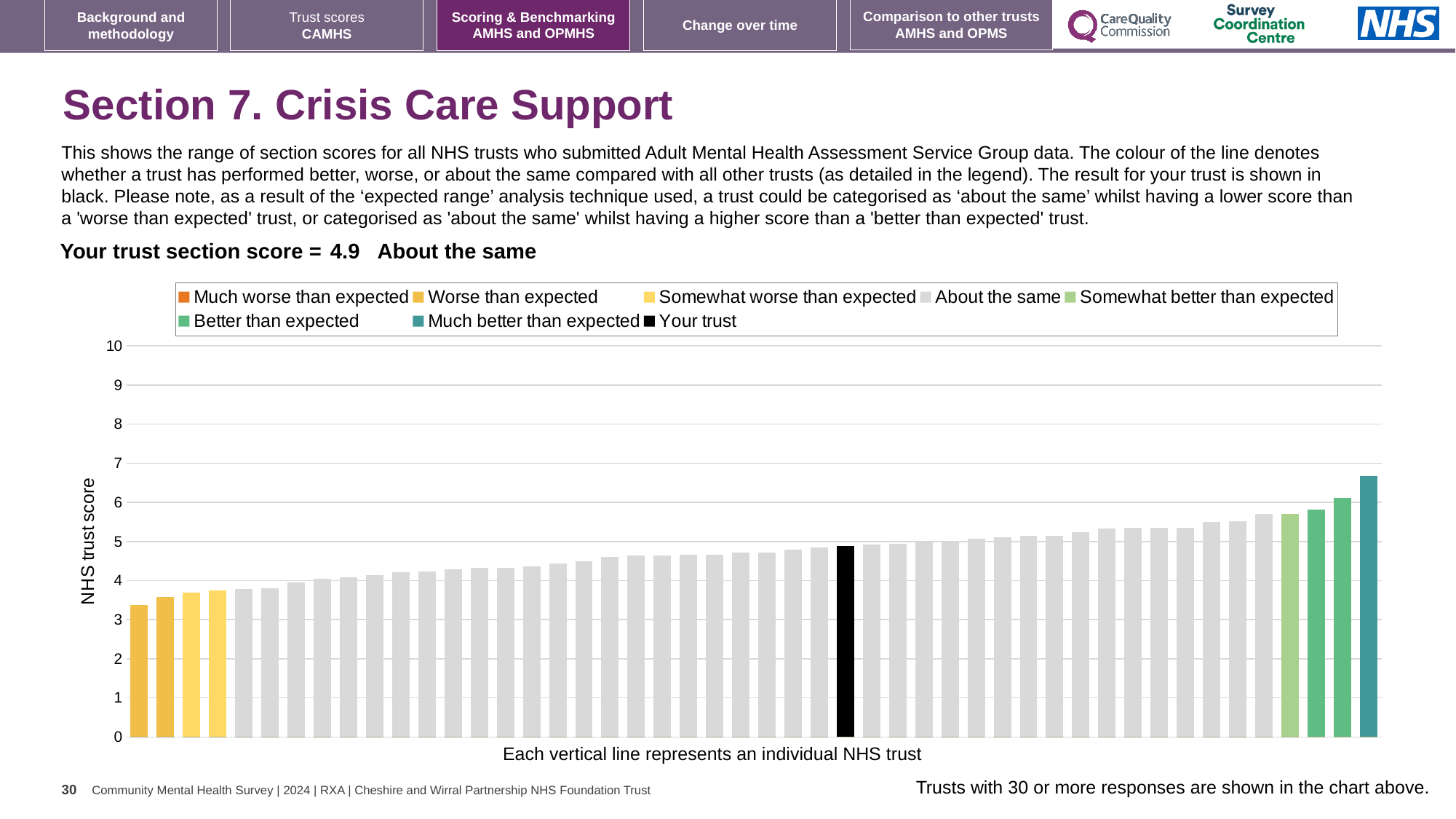
What is the section score for your trust? 4.9 Which legend category does the lowest bar in the chart belong to? Worse than expected How many entries does the chart legend list? 8 Which legend category does the highest bar in the chart belong to? Much better than expected Is the value for your trust (the black bar) greater or less than 4? greater What colour is the bar representing your trust? black Do the bar values rise or fall from left to right along the x axis? rise What kind of chart is shown on the slide? bar chart What is the label on the vertical axis of the chart? NHS trust score Is the value of the highest bar in the chart greater or less than 6? greater How many bars are coloured as 'Much better than expected'? 1 Is the value of the lowest bar in the chart greater or less than 4? less